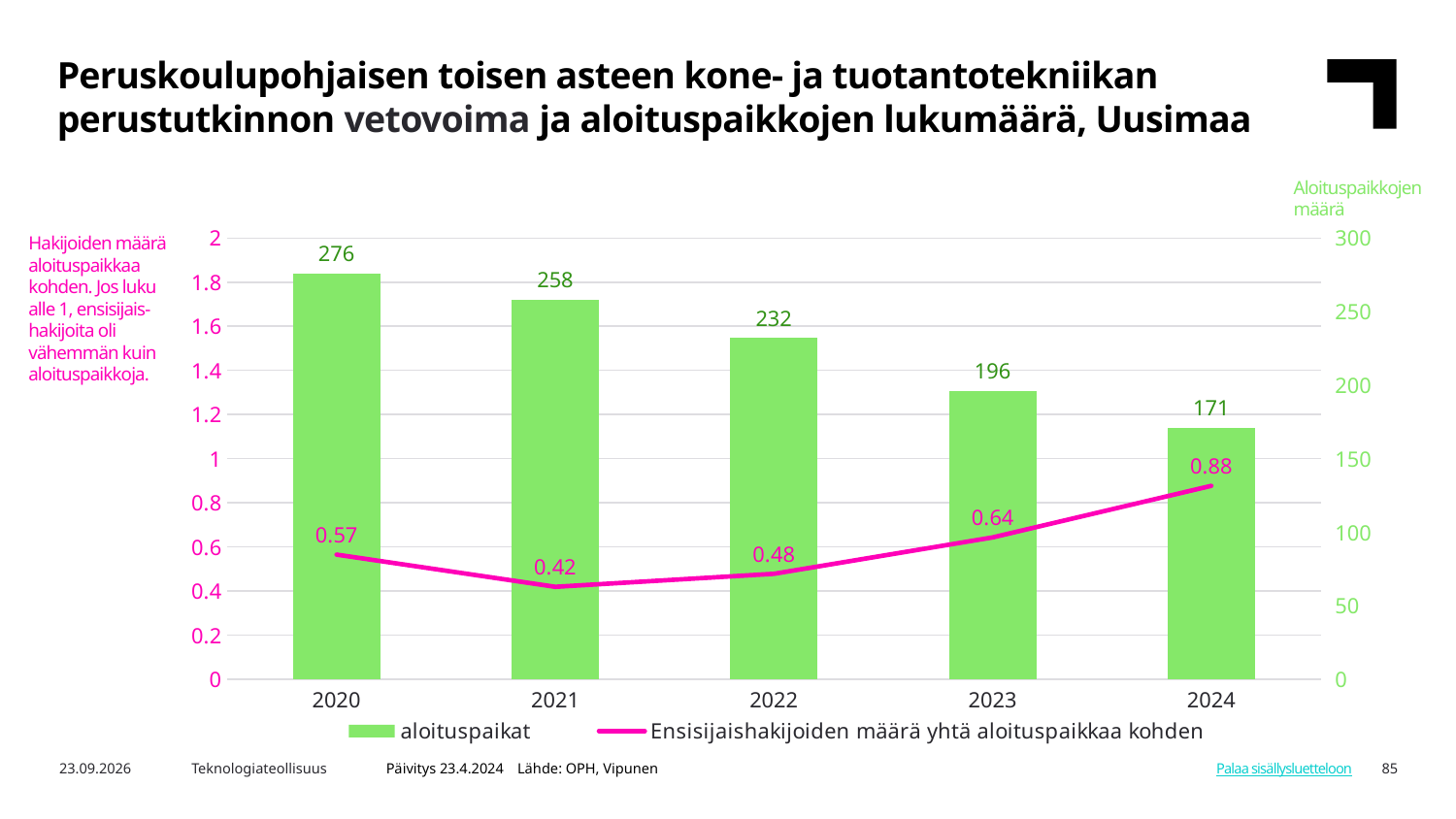
Is the value for Ensisijaishakijoiden määrä yhtä aloituspaikkaa kohden in 2023 greater or less than 1? less What colour are the aloituspaikat bars? green What is the value of Ensisijaishakijoiden määrä yhtä aloituspaikkaa kohden in 2021? 0.42 How many series does the legend list? 2 How many years are shown on the x axis? 5 Which year has the lowest value for aloituspaikat? 2024 Which year has the highest value for Ensisijaishakijoiden määrä yhtä aloituspaikkaa kohden? 2024 What is the value of aloituspaikat in 2020? 276 Which is larger, the aloituspaikat value in 2022 or in 2023? 2022 Do the aloituspaikat values rise or fall from 2020 to 2024? fall What is the value of aloituspaikat in 2024? 171 What is the difference between aloituspaikat in 2020 and 2024? 105